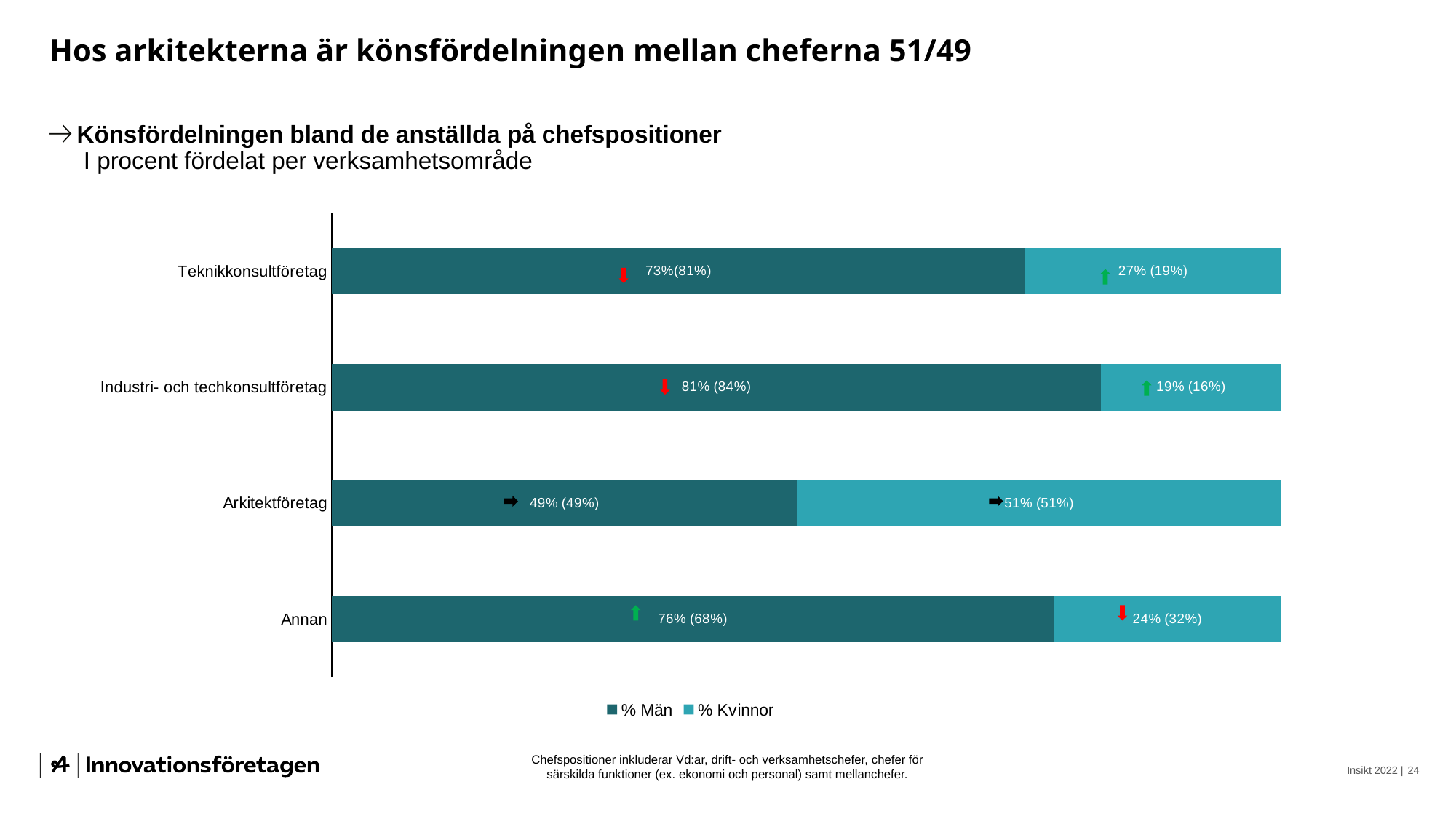
What is the % Kvinnor value for Arkitektföretag? 51% What is the % Kvinnor value for Industri- och techkonsultföretag? 19% Which is larger, the % Kvinnor value for Annan or for Teknikkonsultföretag? Teknikkonsultföretag What kind of chart is shown on the slide? Stacked bar chart Which category has the lowest % Män value? Arkitektföretag How many categories are shown on the chart? 4 How many series does the legend list? 2 What is the difference between the % Kvinnor values for Teknikkonsultföretag and Industri- och techkonsultföretag? 8 percentage points Which category has the highest % Män value? Industri- och techkonsultföretag What value is shown in parentheses next to the % Kvinnor label for Annan? 32% What is the % Män value for Annan? 76% What is the % Män value for Teknikkonsultföretag? 73%